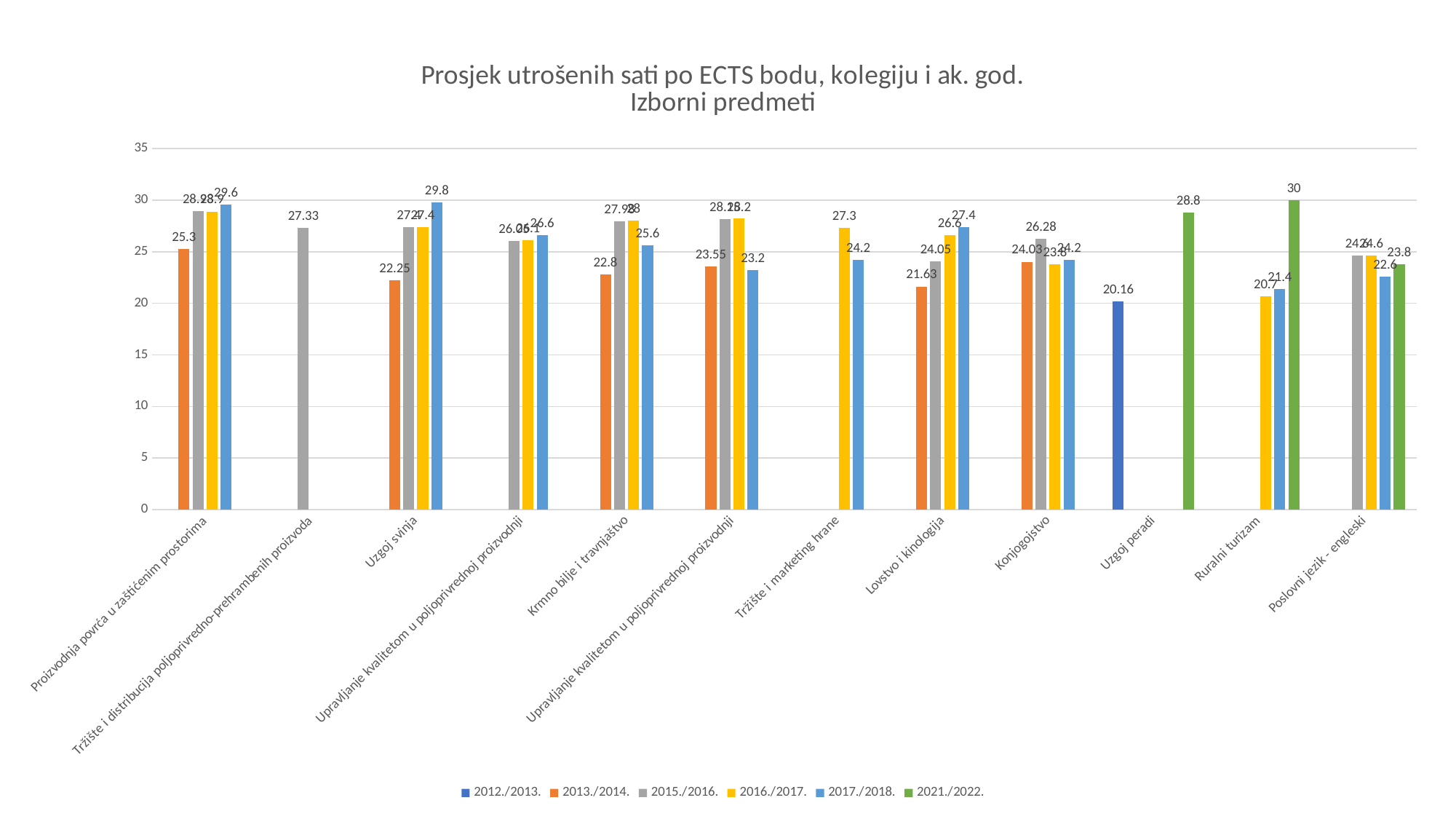
Is the value for Uzgoj peradi in 2012./2013. greater or less than 25? less What is the value for Lovstvo i kinologija in the 2013./2014. series? 21.63 In the 2017./2018. series, which is larger: Lovstvo i kinologija or Konjogojstvo? Lovstvo i kinologija What is the value for Uzgoj peradi in the 2012./2013. series? 20.16 For Ruralni turizam, which academic year has the highest value? 2021./2022. How many series does the legend list? 6 What is the value for Tržište i distribucija poljoprivredno-prehrambenih proizvoda in the 2015./2016. series? 27.33 For Lovstvo i kinologija, which academic year has the lowest value? 2013./2014. What kind of chart is shown on the slide? Bar chart For Ruralni turizam, what is the difference between the 2021./2022. value and the 2016./2017. value? 9.3 What is the value for Ruralni turizam in the 2021./2022. series? 30 What is the value for Konjogojstvo in the 2015./2016. series? 26.28